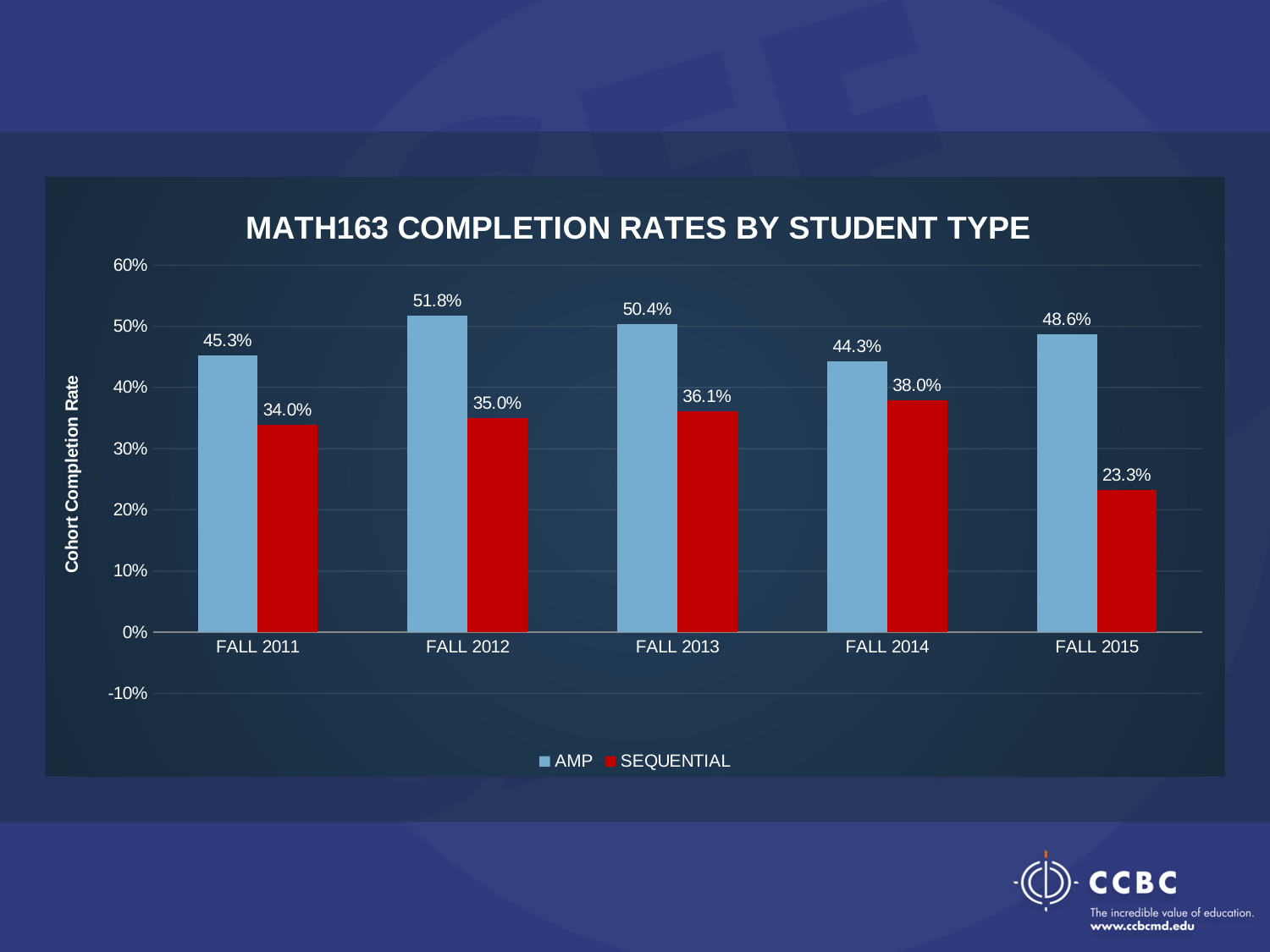
What is the SEQUENTIAL completion rate for FALL 2015? 23.3% Which term has the lowest SEQUENTIAL completion rate? FALL 2015 What is the title of the chart? MATH163 COMPLETION RATES BY STUDENT TYPE What is the SEQUENTIAL completion rate for FALL 2014? 38.0% What is the AMP completion rate for FALL 2012? 51.8% How many series does the legend list? 2 What is the difference between the AMP and SEQUENTIAL completion rates in FALL 2015? 25.3% What kind of chart is shown on the slide? bar chart Which term has the highest AMP completion rate? FALL 2012 Which is larger in FALL 2013, the AMP rate or the SEQUENTIAL rate? AMP How many terms are shown on the x axis? 5 Is the AMP completion rate for FALL 2014 greater or less than 40%? greater